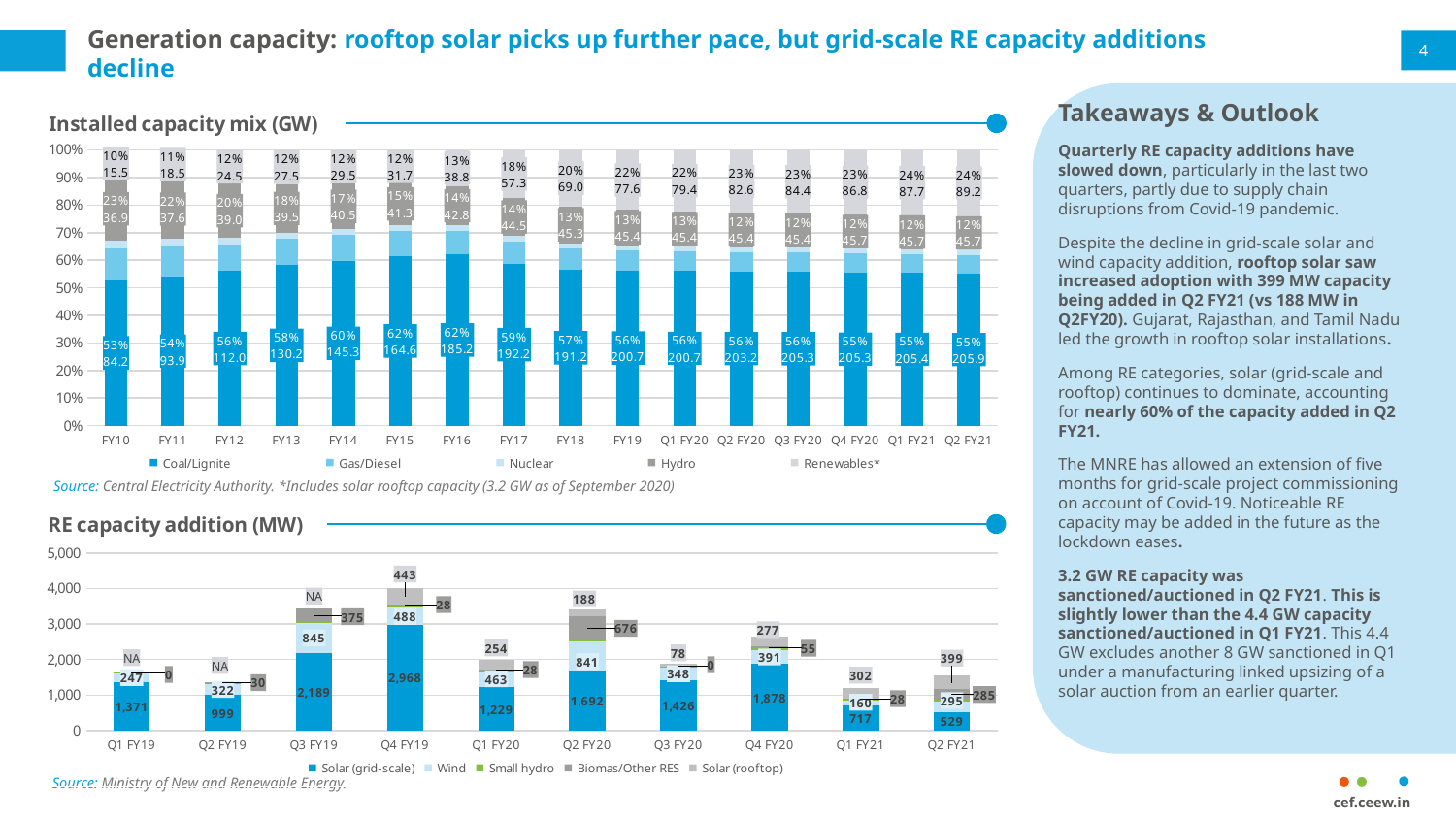
In the "Installed capacity mix (GW)" chart, does the Coal/Lignite capacity in GW rise or fall from FY10 to FY16? Rise What is the title of the lower chart on the slide? RE capacity addition (MW) What kind of chart is the "Installed capacity mix (GW)" chart? Stacked bar chart In the "RE capacity addition (MW)" chart, which quarter has the lowest Solar (grid-scale) addition? Q2 FY21 In the "RE capacity addition (MW)" chart, what is the Solar (grid-scale) value for Q4 FY19? 2,968 In the "Installed capacity mix (GW)" chart, what is the Renewables* capacity in GW for Q2 FY21? 89.2 In the "RE capacity addition (MW)" chart, how much higher is the Solar (rooftop) addition in Q2 FY21 than in Q2 FY20? 211 How many series does the legend of the "Installed capacity mix (GW)" chart list? 5 In the "RE capacity addition (MW)" chart, which quarter has the highest Solar (grid-scale) addition? Q4 FY19 In the "RE capacity addition (MW)" chart, which quarter has the larger Wind addition, Q3 FY19 or Q4 FY19? Q3 FY19 In the "Installed capacity mix (GW)" chart, what percentage share does Coal/Lignite have in FY15? 62% In the "RE capacity addition (MW)" chart, how many quarters are shown on the x axis? 10